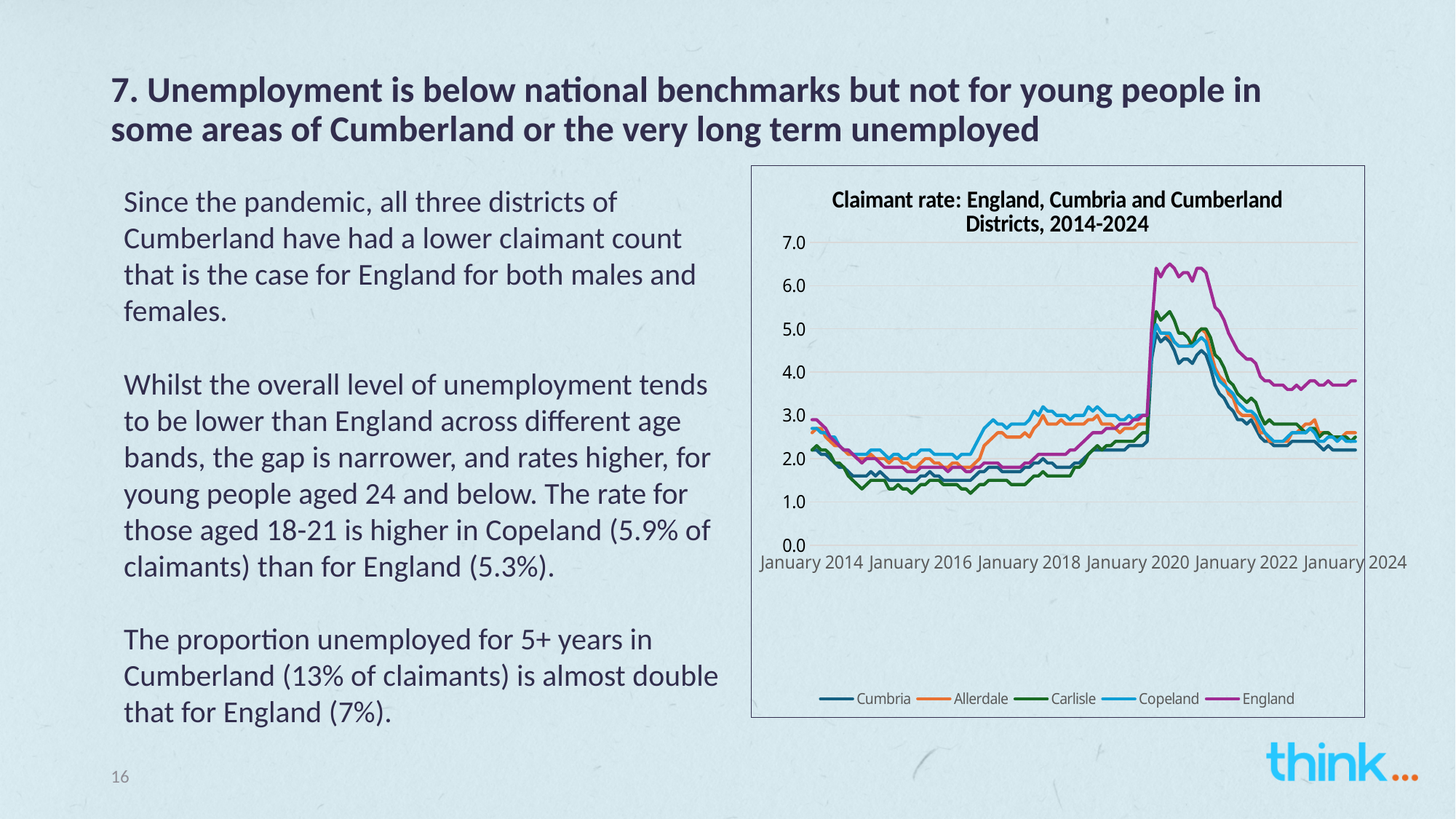
At January 2024, which series has the higher value, England or Cumbria? England Is the value for Cumbria at January 2024 greater or less than 3.0? less Which series reaches the highest value on the claimant rate chart? England Around January 2018, which series has the higher value, Copeland or Carlisle? Copeland Does the England series rise or fall between its peak in 2020 and January 2022? Fall Is the value for England at January 2024 greater or less than 3.0? greater Is the value for Carlisle at January 2016 greater or less than 2.0? less What is the title of the chart on the slide? Claimant rate: England, Cumbria and Cumberland Districts, 2014-2024 How many series does the legend of the claimant rate chart list? 5 Which series is drawn in purple on the claimant rate chart? England What kind of chart is shown on the slide? Line chart